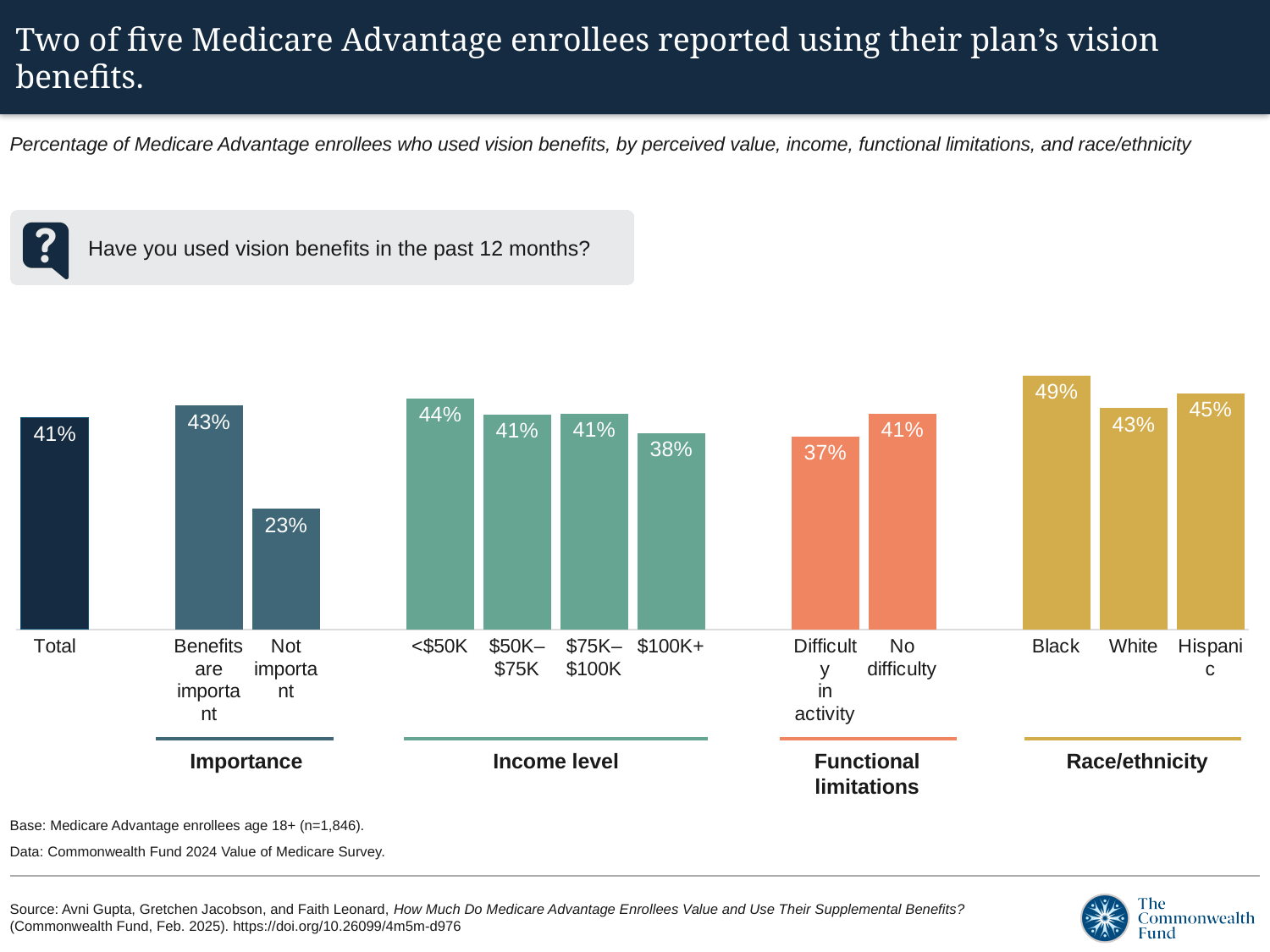
Which category has the lowest percentage of enrollees using vision benefits? Not important Do the values fall or rise as income level increases from <$50K to $100K+? Fall Which category has the highest percentage of enrollees using vision benefits? Black What is the value for Hispanic enrollees? 45% What is the difference between enrollees with no difficulty and those with difficulty in activity? 4% How many bars are plotted in the chart? 12 What is the difference between the value for Black enrollees and the value for White enrollees? 6% What is the value for enrollees with income of $100K+? 38% What percentage of all Medicare Advantage enrollees (Total) reported using vision benefits? 41% Which is larger, the value for <$50K or the value for $100K+? <$50K What type of chart is shown on the slide? Bar chart What is the value for enrollees who said benefits are not important? 23%